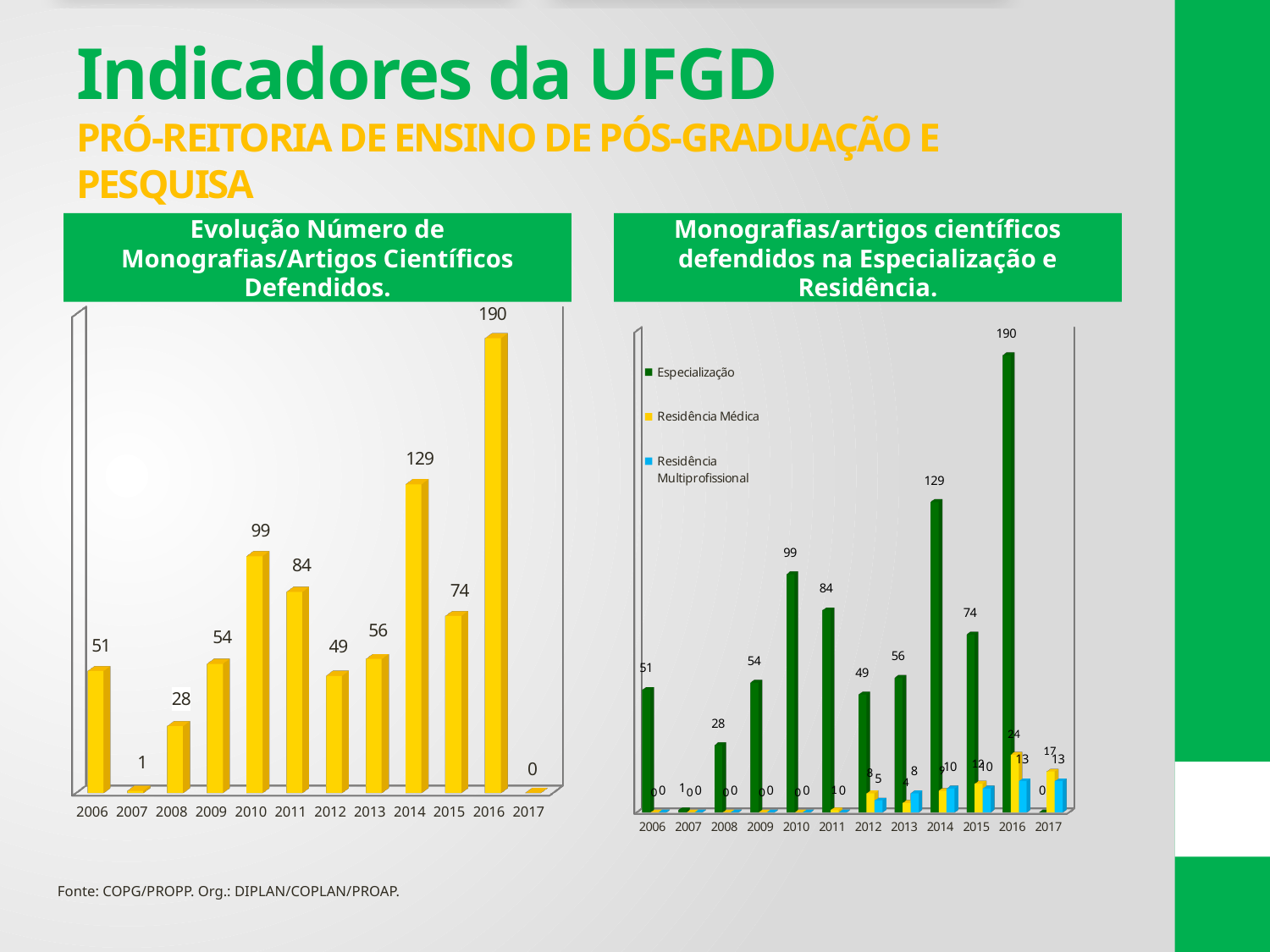
What kind of chart is the left chart 'Evolução Número de Monografias/Artigos Científicos Defendidos'? Bar chart In the right chart 'Monografias/artigos científicos defendidos na Especialização e Residência', what is the Especialização value for 2017? 0 In the right chart 'Monografias/artigos científicos defendidos na Especialização e Residência', what is the Residência Multiprofissional value for 2013? 8 In the left chart 'Evolução Número de Monografias/Artigos Científicos Defendidos', what is the difference between the values for 2014 and 2015? 55 In the left chart 'Evolução Número de Monografias/Artigos Científicos Defendidos', which year has the larger value, 2011 or 2013? 2011 In the right chart 'Monografias/artigos científicos defendidos na Especialização e Residência', which series is shown in dark green? Especialização In the left chart 'Evolução Número de Monografias/Artigos Científicos Defendidos', what is the value for 2016? 190 How many years are shown on the x axis of the left chart 'Evolução Número de Monografias/Artigos Científicos Defendidos'? 12 In the left chart 'Evolução Número de Monografias/Artigos Científicos Defendidos', which year has the highest value? 2016 In the left chart 'Evolução Número de Monografias/Artigos Científicos Defendidos', which year has the lowest value? 2017 In the left chart 'Evolução Número de Monografias/Artigos Científicos Defendidos', what is the value for 2010? 99 How many series does the legend of the right chart 'Monografias/artigos científicos defendidos na Especialização e Residência' list? 3